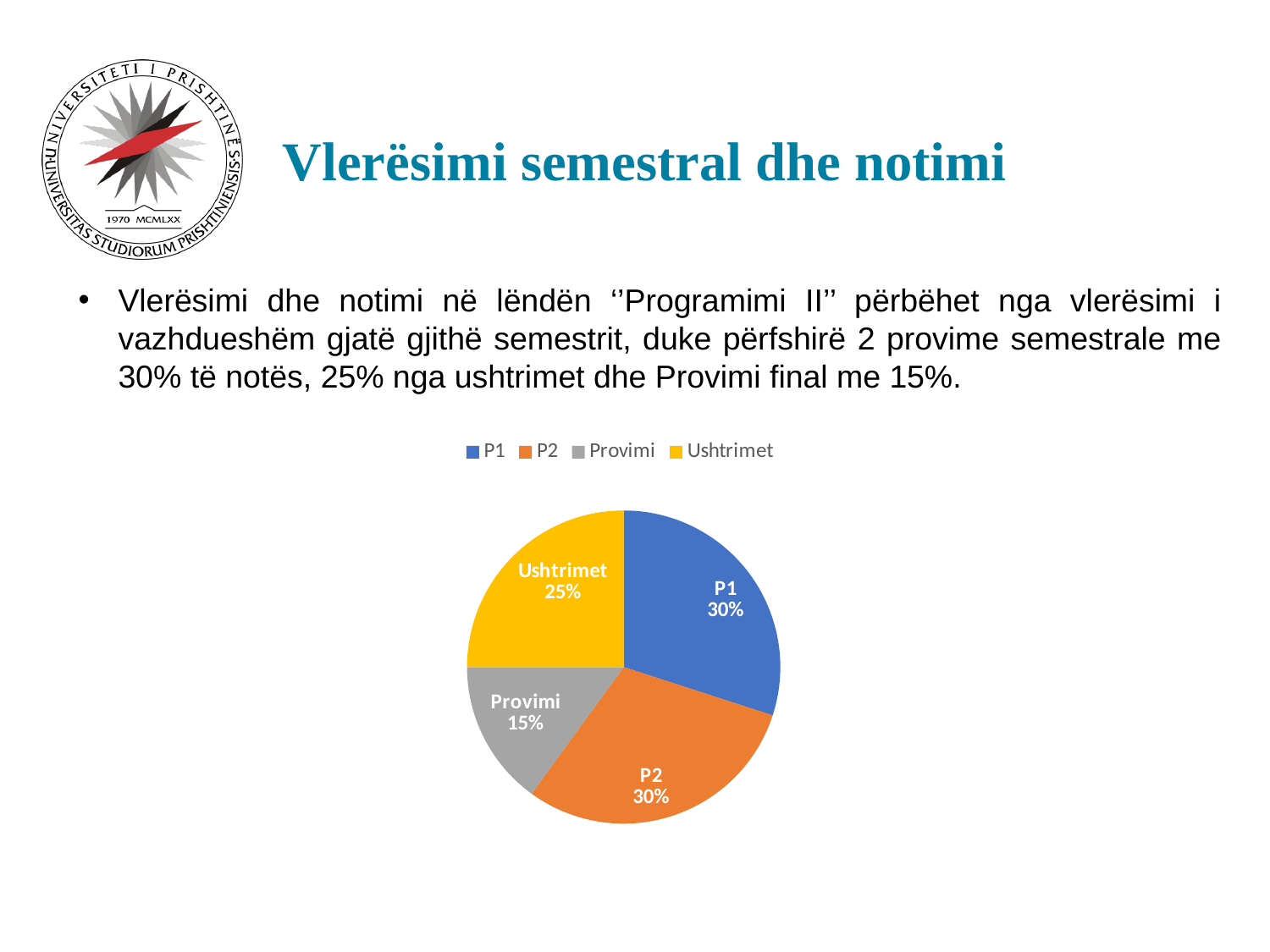
What share of the pie does Ushtrimet represent? 25% What colour is the Provimi slice in the pie chart? grey What share of the pie does P1 represent? 30% How many slices does the pie chart have? 4 What is the difference between the Ushtrimet share and the Provimi share? 10% What is the difference between the P1 share and the Ushtrimet share? 5% Which slice of the pie is the smallest? Provimi Which is larger, the share for Ushtrimet or the share for Provimi? Ushtrimet What is the value shown for P2? 30% How many entries does the legend list? 4 What share of the pie does Provimi represent? 15% What kind of chart is shown on the slide? pie chart